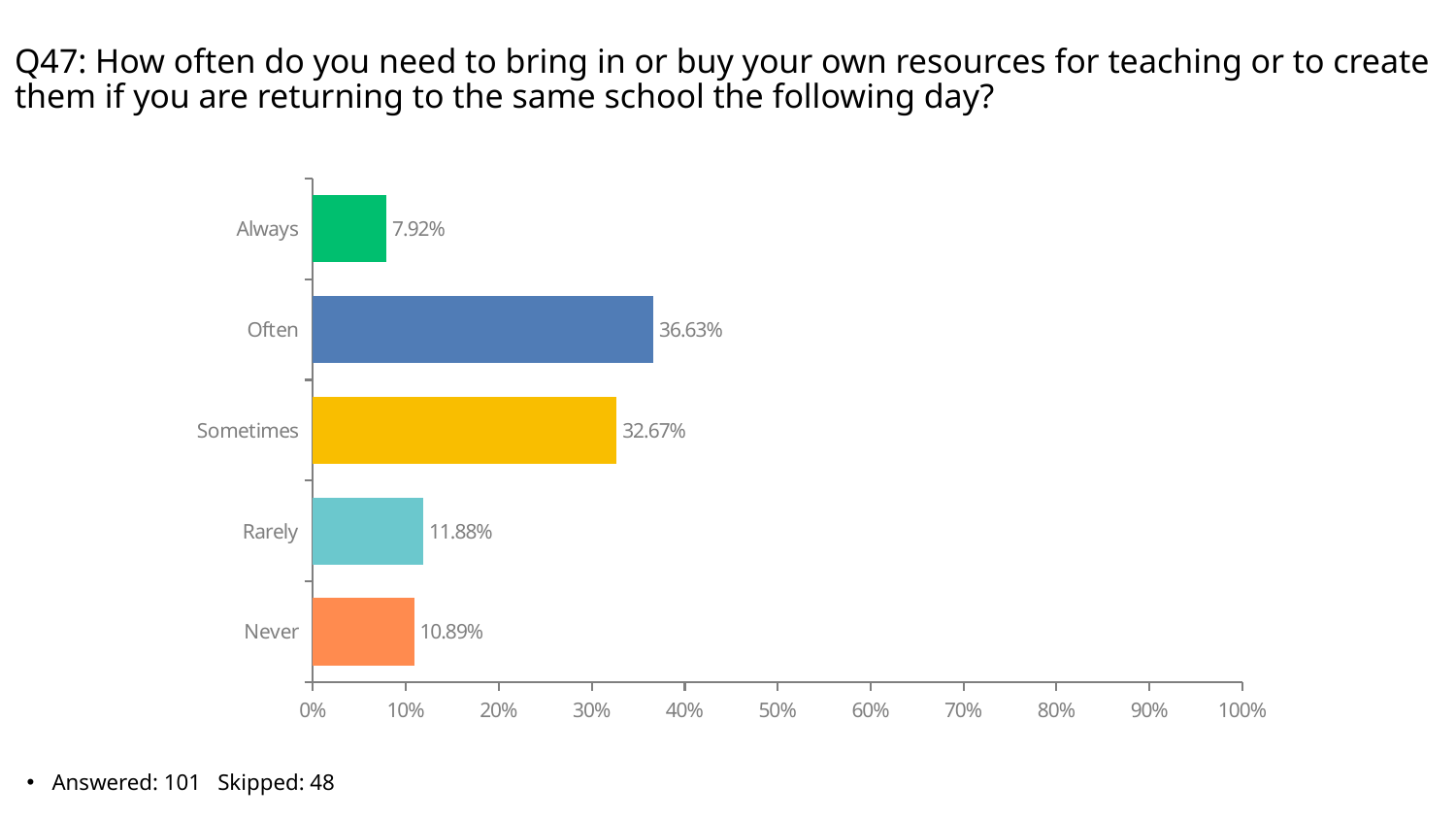
What percentage is shown for "Sometimes"? 32.67% What type of chart is shown on the slide? Bar chart What percentage of respondents answered "Often"? 36.63% What colour is the bar for "Sometimes"? Yellow Is the value for "Sometimes" greater or less than 30%? greater Which is larger, the value for "Rarely" or the value for "Never"? Rarely How many response categories are shown in the chart? 5 Which category has the highest percentage? Often Which category has the lowest percentage? Always What is the value shown for "Never"? 10.89% What is the difference between the "Often" and "Sometimes" percentages? 3.96% What is the combined percentage of "Always" and "Often"? 44.55%